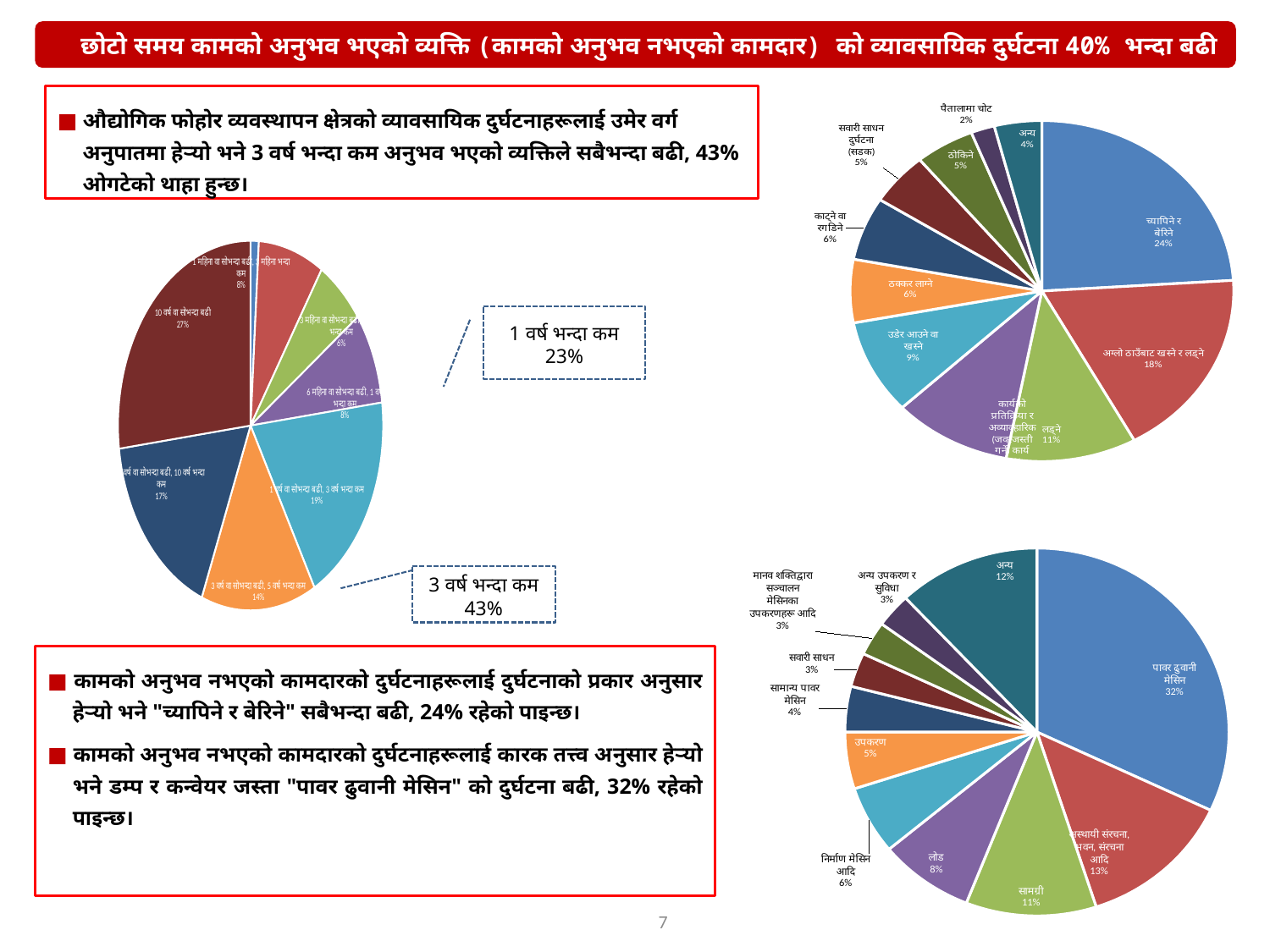
In the pie chart on the left of the slide, what share is shown for 10 वर्ष वा सोभन्दा बढी? 27% In the pie chart at the bottom right of the slide, how many categories are shown? 11 In the pie chart at the top right of the slide, what is the difference between the shares for च्यापिने र बेरिने and उडेर आउने वा खस्ने? 15% In the pie chart at the top right of the slide, which category has the smallest slice? पैतालामा चोट In the pie chart at the top right of the slide, which category has the largest slice? च्यापिने र बेरिने In the pie chart at the bottom right of the slide, which is larger: लोड or निर्माण मेसिन आदि? लोड In the pie chart at the top right of the slide, what share is shown for च्यापिने र बेरिने? 24% In the pie chart at the bottom right of the slide, what share is shown for सामग्री? 11% In the pie chart at the bottom right of the slide, what share is shown for पावर ढुवानी मेसिन? 32% In the pie chart at the top right of the slide, what share is shown for अग्लो ठाउँबाट खस्ने र लड्ने? 18% What kind of chart is used for the three charts on this slide? Pie chart In the pie chart at the bottom right of the slide, what is the difference between the shares for पावर ढुवानी मेसिन and अस्थायी संरचना, भवन, संरचना आदि? 19%